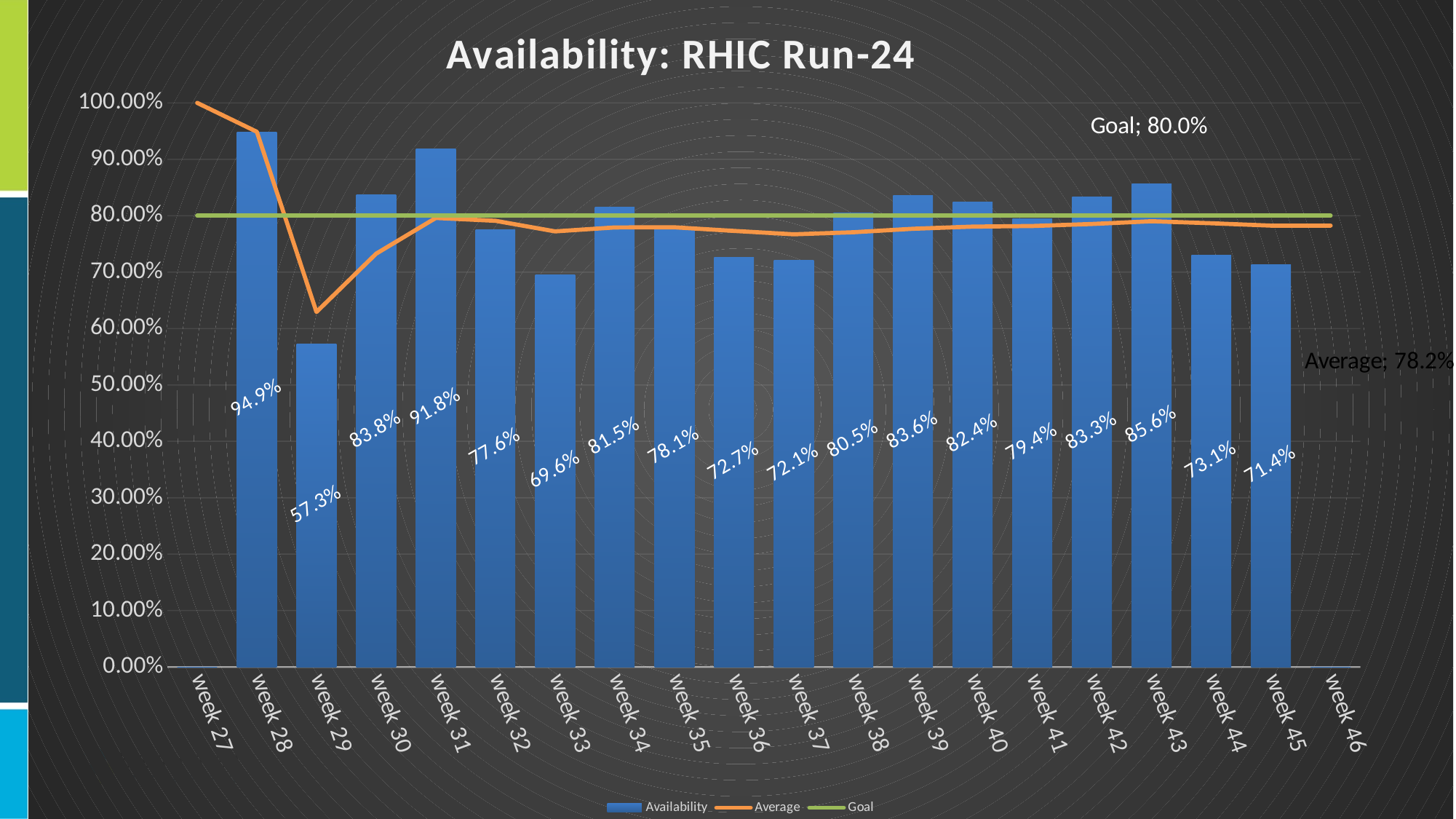
What is the difference between the availability for week 28 and week 29? 37.6 percentage points Which week has the lowest labeled availability value? week 29 What is the title of the chart? Availability: RHIC Run-24 Which week has the highest availability bar? week 28 How many week categories are shown on the x axis? 20 Which has the higher availability, week 31 or week 43? week 31 What value is shown for the Goal line? 80.0% What value is shown for the Average? 78.2% What is the availability value for week 37? 72.1% What is the availability value for week 43? 85.6% What is the availability value for week 28? 94.9% How many series does the legend list? 3